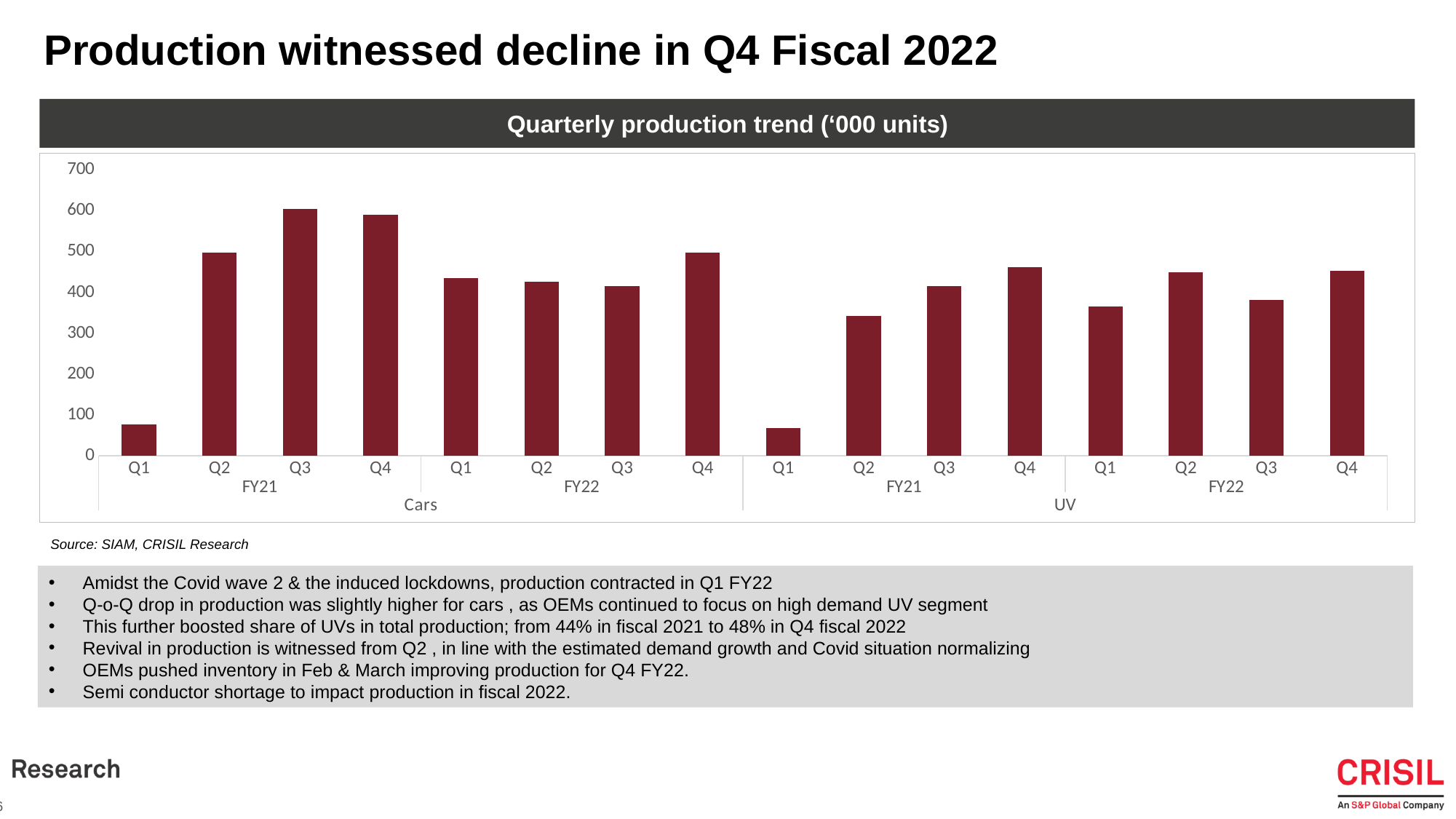
How many bars are plotted in the chart? 16 Is the value for UV Q1 FY22 greater or less than 400? less Is the value for Cars Q1 FY21 greater or less than 100? less Do the UV values rise or fall from Q1 FY21 to Q4 FY21? rise Which is larger, Cars Q3 FY21 or Cars Q4 FY22? Cars Q3 FY21 Is the value for UV Q2 FY21 greater or less than 300? greater Within the Cars group, which quarter has the lowest bar? Q1 FY21 Which quarter has the highest bar in the chart? Q3 FY21 (Cars) Which is larger, UV Q4 FY21 or UV Q1 FY22? UV Q4 FY21 What kind of chart is shown on the slide? bar chart What is the title of the chart? Quarterly production trend ('000 units)